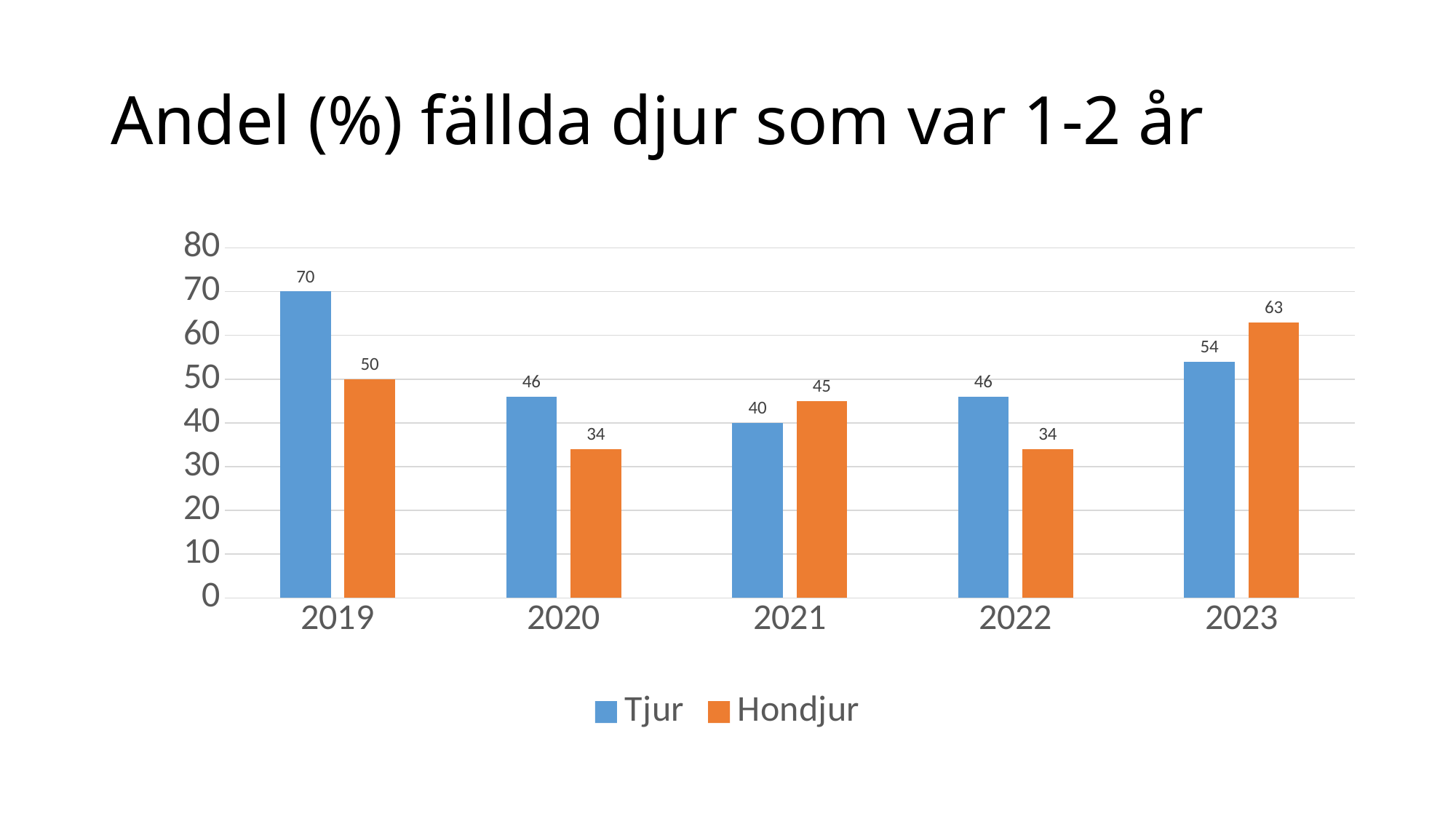
What is the value for Hondjur in 2021? 45 In which year is the Tjur value lowest? 2021 What is the value for Hondjur in 2023? 63 What kind of chart is shown? Bar chart Which is larger in 2022, Tjur or Hondjur? Tjur How many series does the legend list? 2 How many years are shown on the x axis? 5 What is the difference between the Tjur and Hondjur values in 2019? 20 In which year is the Tjur value highest? 2019 Which is larger in 2023, Tjur or Hondjur? Hondjur What is the title of the chart? Andel (%) fällda djur som var 1-2 år What is the value for Tjur in 2019? 70